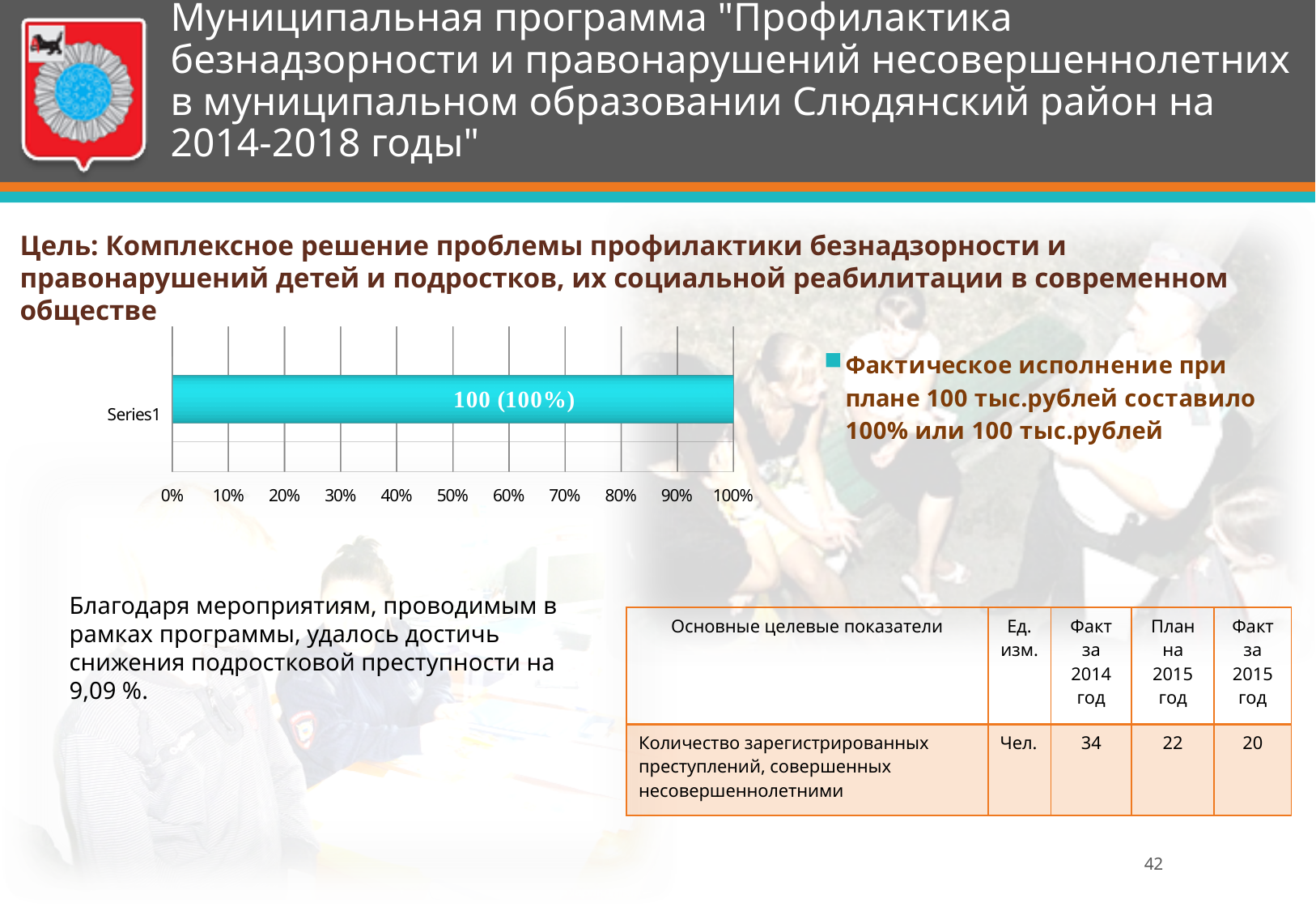
What is the highest tick label shown on the horizontal axis of the chart? 100% Is the value for Series1 greater or less than 90%? greater What percentage does the bar for Series1 reach according to its data label? 100% How many bars are plotted in the chart? 1 What is the data label printed on the bar for Series1? 100 (100%) What is the label of the single category on the vertical axis of the chart? Series1 Is the value for Series1 greater or less than 50%? greater What kind of chart is shown on the slide? bar chart